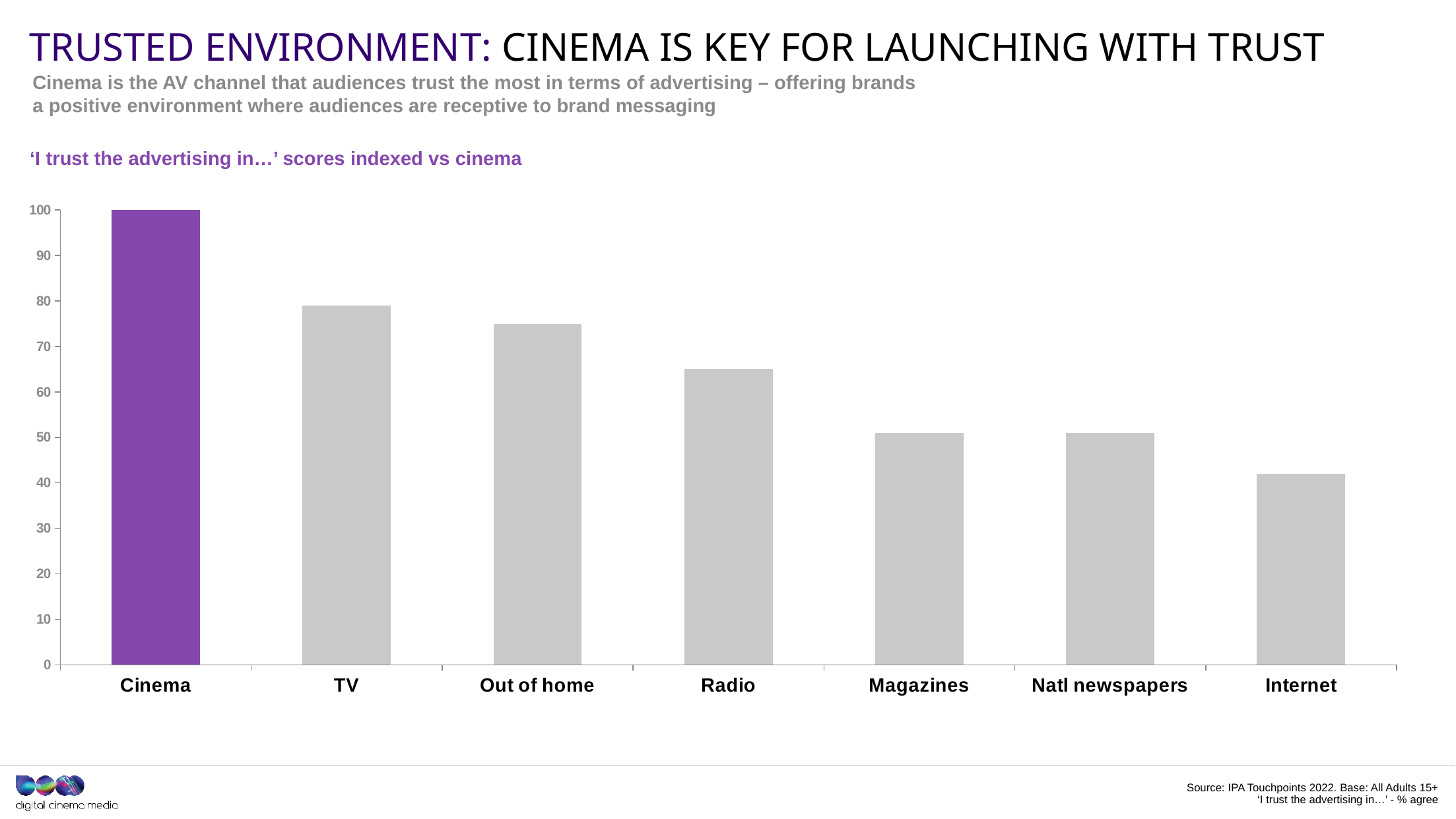
What kind of chart is shown on the slide? Bar chart What is the value for Cinema? 100 Is the value for Internet greater or less than 50? less Which has a higher value, Out of home or Internet? Out of home Is the value for Out of home greater or less than 70? greater How many categories are shown on the x axis? 7 Which bar is coloured purple rather than grey? Cinema Which category has the highest value? Cinema Is the value for Radio greater or less than 60? greater Which category has the lowest value? Internet Which has a higher value, TV or Radio? TV